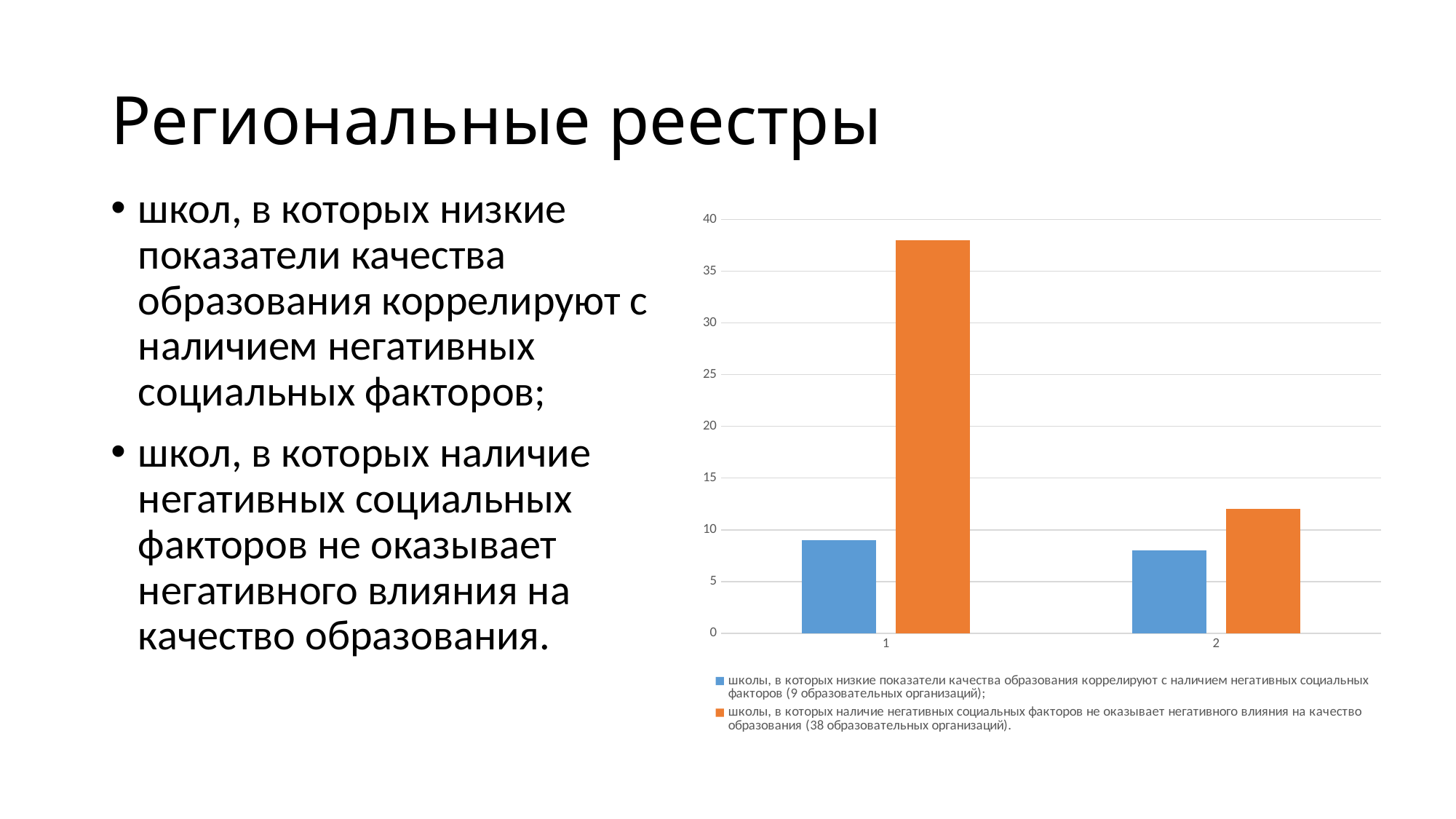
Is the blue bar for category 2 greater or less than 10? less Is the orange bar for category 1 greater or less than 35? greater Is the orange bar for category 1 greater or less than 40? less Does the orange series rise or fall from category 1 to category 2? fall Which bar is the tallest in the chart? the orange bar for category 1 For the orange series, which category has the larger value, 1 or 2? 1 How many series does the chart legend list? 2 What kind of chart is shown on the slide? bar chart How many categories are shown on the x axis of the chart? 2 For category 1, which series has the larger value, the blue or the orange? orange